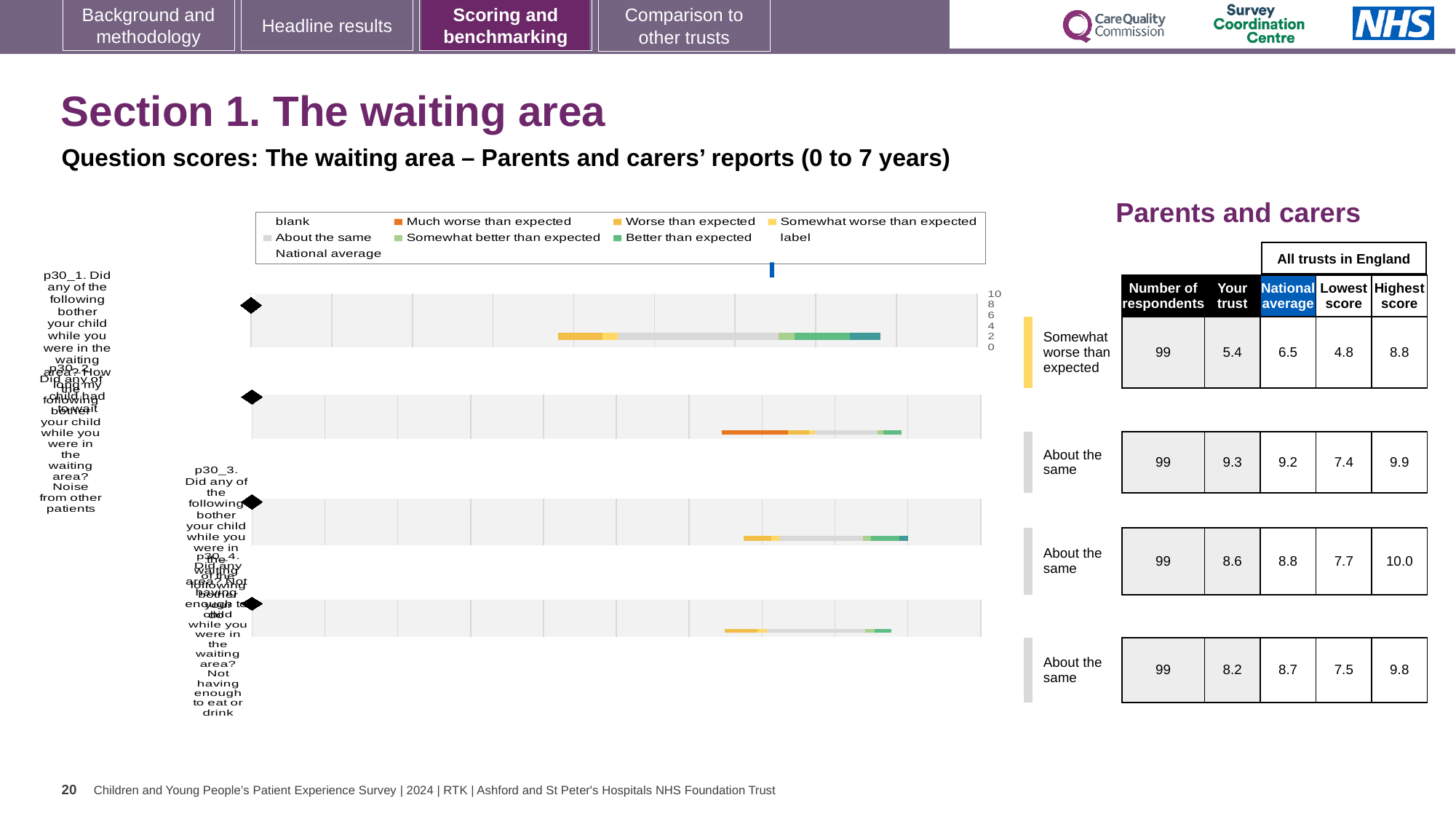
How many respondents are listed for each question in the table? 99 What kind of chart is shown on the slide? bar chart In the third row of the table, which is larger: the 'Your trust' score or the National average? National average What is the difference between the highest and lowest 'Your trust' scores in the table? 3.9 In the table, what is the National average in the first row? 6.5 What colour represents 'Much worse than expected' in the chart legend? orange What benchmark label is given to the first question in the chart? Somewhat worse than expected How many questions (bars) are plotted in the chart? 4 In the table, what is the 'Your trust' score in the first row (Somewhat worse than expected)? 5.4 What is the lowest 'Your trust' score in the table? 5.4 In the table, what is the Highest score in the second row? 9.9 Which row of the table has the highest 'Your trust' score? the second row (9.3)